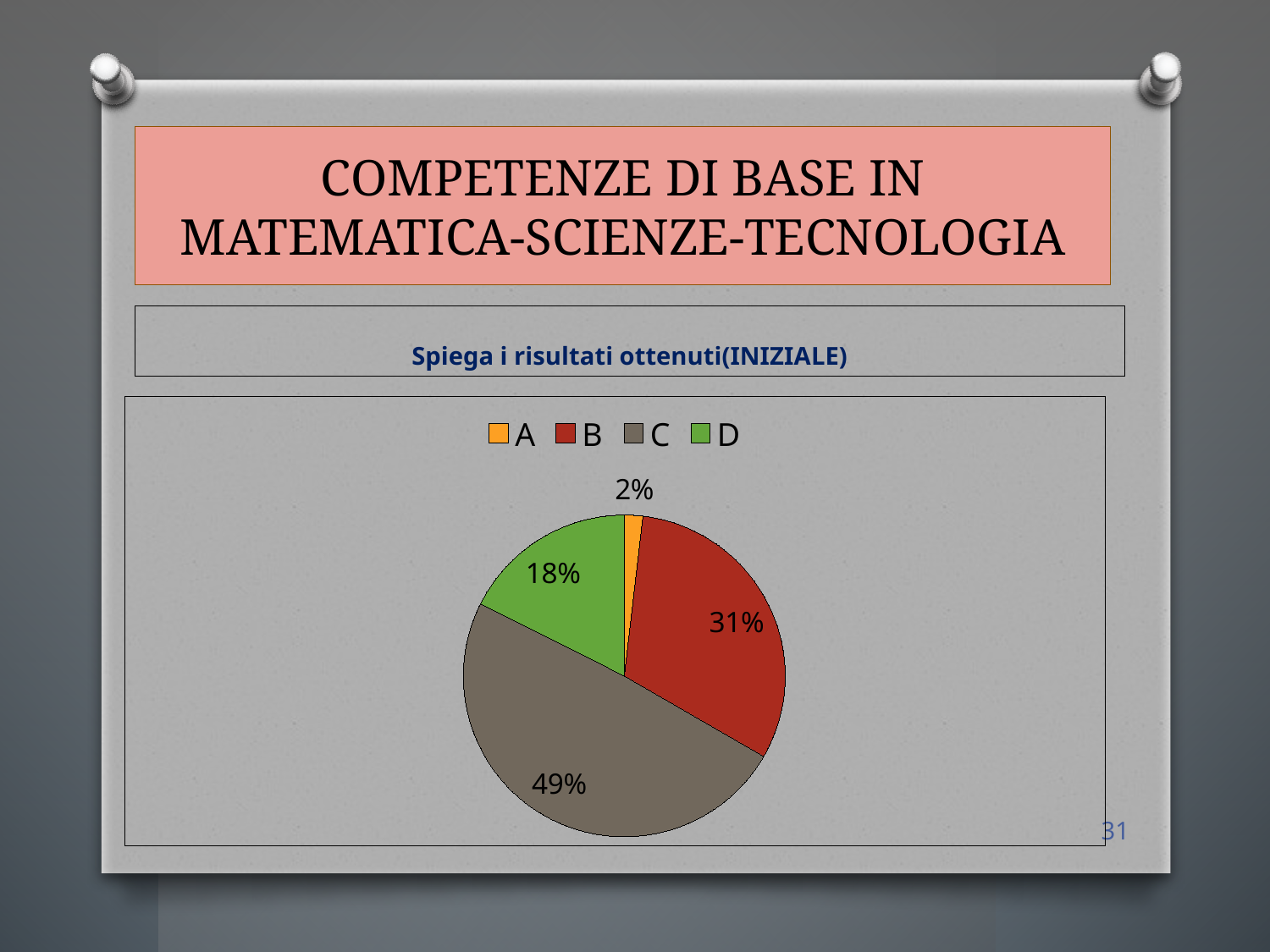
What percentage does slice D represent? 18% Which is larger, slice B or slice D? B What is the difference in percentage points between slice C and slice B? 18 What percentage does slice C represent? 49% What percentage does slice B represent? 31% What colour is the slice for category D? green Which category has the largest share of the pie? C What percentage does slice A represent? 2% What kind of chart is shown on the slide? pie chart Which category has the smallest share of the pie? A How many categories does the legend list? 4 What is the title shown above the chart? Spiega i risultati ottenuti(INIZIALE)